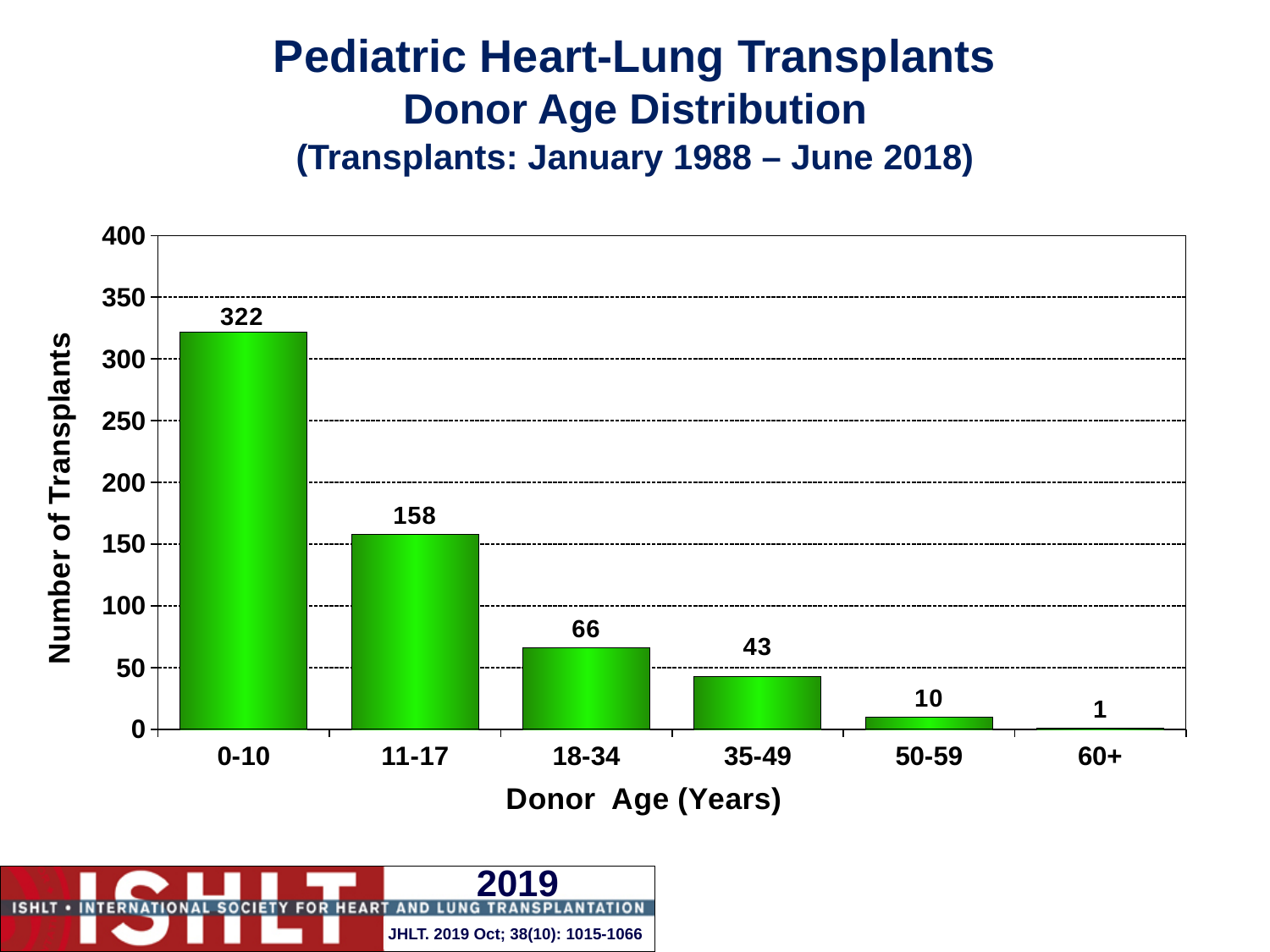
Is the number of transplants for the 11-17 donor age group greater or less than 150? greater What is the difference in number of transplants between the 18-34 and 35-49 donor age groups? 23 Do the number of transplants rise or fall as donor age increases along the x axis? Fall How many donor age groups are shown on the x axis? 6 What is the number of transplants for donors aged 11-17? 158 What is the number of transplants for the 35-49 donor age group? 43 Which donor age group has more transplants, 18-34 or 50-59? 18-34 Which donor age group has the highest number of transplants? 0-10 What is the difference in number of transplants between the 0-10 and 11-17 donor age groups? 164 Which donor age group has the lowest number of transplants? 60+ What kind of chart is shown on the slide? Bar chart How many transplants are shown for the 0-10 donor age group? 322